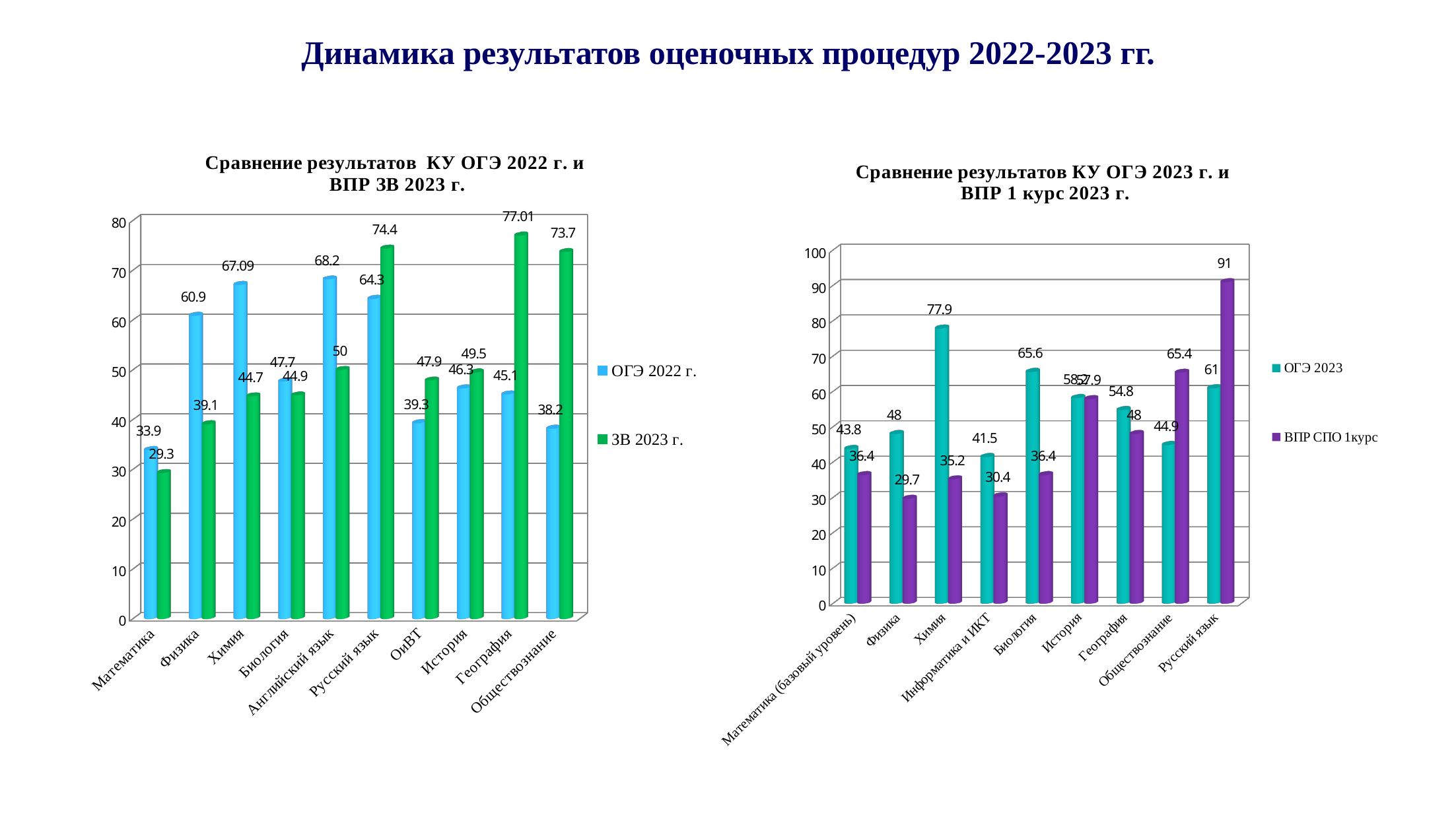
In the left chart, what is the ЗВ 2023 г. value for География? 77.01 In the right chart, which subject has the lowest ВПР СПО 1курс value? Физика In the left chart (Сравнение результатов КУ ОГЭ 2022 г. и ВПР ЗВ 2023 г.), what is the ОГЭ 2022 г. value for Физика? 60.9 In the left chart, which subject has the highest ОГЭ 2022 г. value? Английский язык In the left chart, how many subjects are shown on the x axis? 10 In the right chart, which is larger for Обществознание: ОГЭ 2023 or ВПР СПО 1курс? ВПР СПО 1курс In the right chart, what is the ОГЭ 2023 value for Химия? 77.9 In the left chart, what is the difference between the ЗВ 2023 г. and ОГЭ 2022 г. values for Обществознание? 35.5 In the right chart (Сравнение результатов КУ ОГЭ 2023 г. и ВПР 1 курс 2023 г.), what is the ВПР СПО 1курс value for Русский язык? 91 In the left chart, which subject has the lowest ЗВ 2023 г. value? Математика What type of chart is the right chart? Bar chart In the right chart, how many series does the legend list? 2